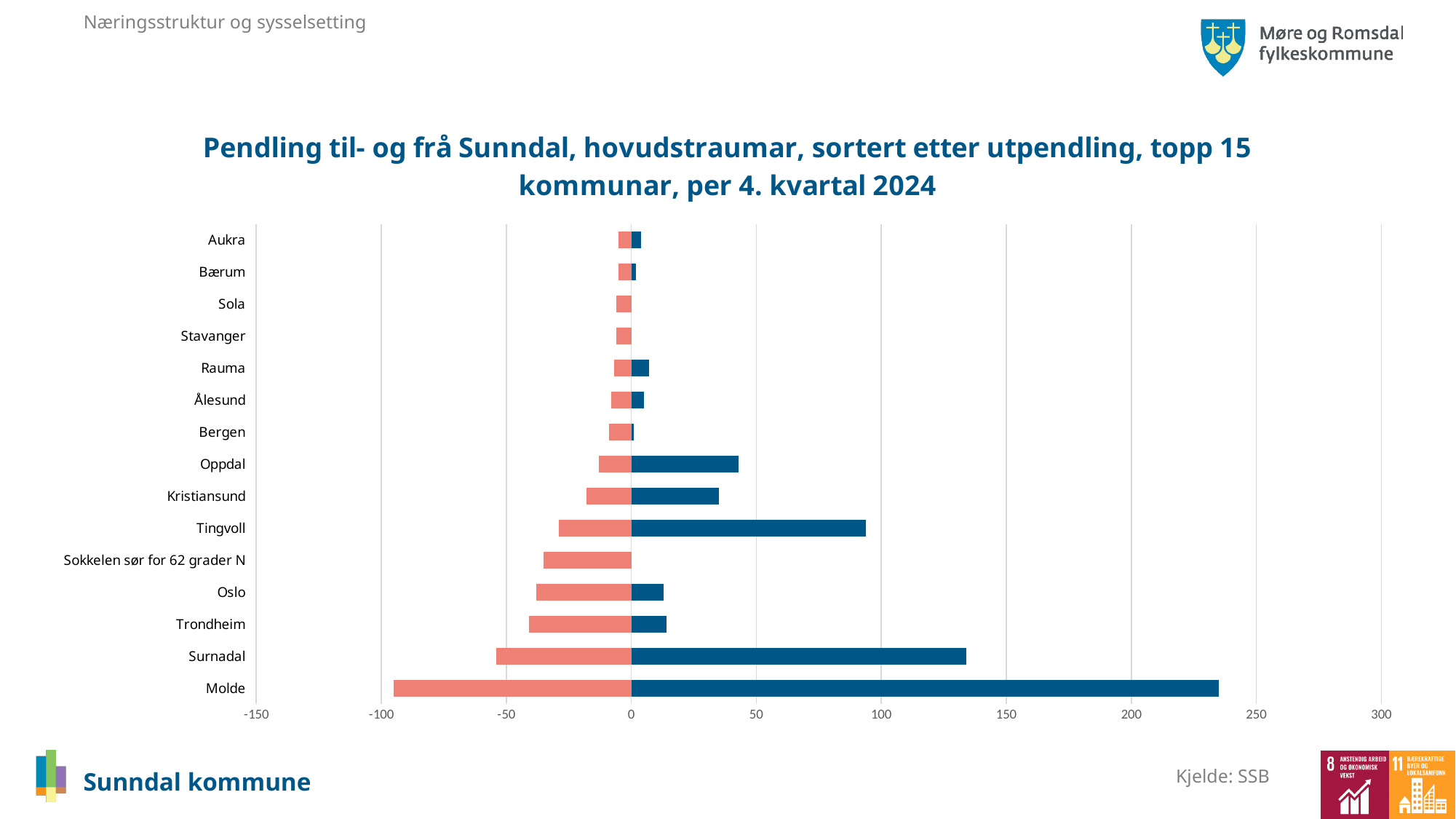
Which municipality has the longest blue (positive) bar? Molde How many municipalities (categories) are listed on the chart? 15 Is the blue bar value for Tingvoll greater or less than 100? less Is the blue bar value for Oppdal greater or less than 50? less Is the blue bar value for Surnadal greater or less than 100? greater Which has the larger blue bar, Surnadal or Tingvoll? Surnadal Which has the longer red bar, Surnadal or Trondheim? Surnadal Which municipality has the longest red (negative) bar? Molde What is the source cited for the chart data? SSB What kind of chart is shown on the slide? bar chart